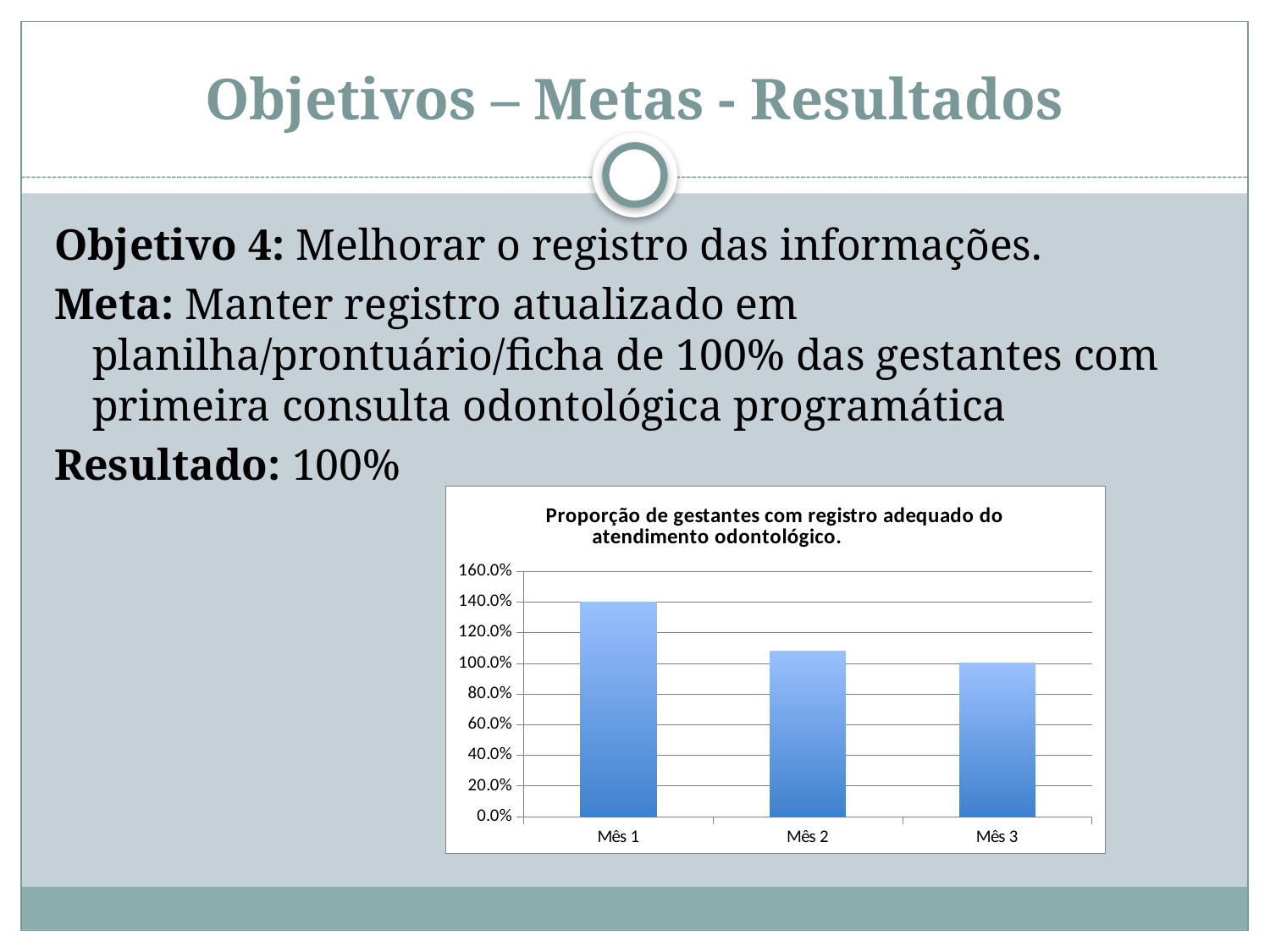
What kind of chart is shown on the slide? bar chart Is the value for Mês 3 greater or less than 120.0%? less How many categories (months) are plotted in the chart? 3 Is the value for Mês 2 greater or less than 120.0%? less Which month has the highest bar in the chart? Mês 1 What is the highest value shown on the vertical axis of the chart? 160.0% Is the value for Mês 2 greater or less than 100.0%? greater Do the values rise or fall from Mês 1 to Mês 3? fall Which is larger, the value for Mês 1 or the value for Mês 2? Mês 1 What is the title of the chart? Proporção de gestantes com registro adequado do atendimento odontológico. Which month has the lowest bar in the chart? Mês 3